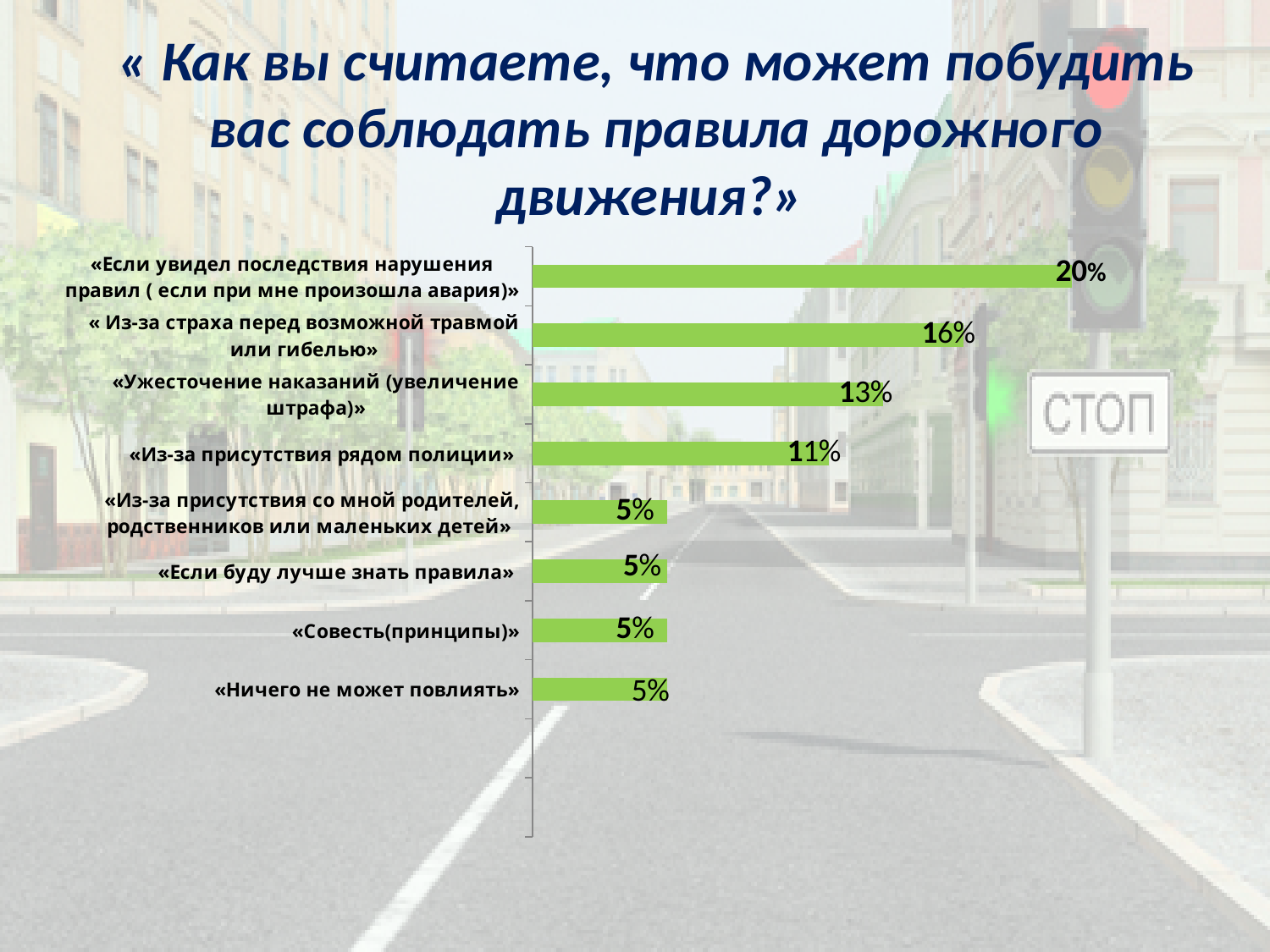
How many categories does the chart show? 8 What is the difference between the values for «Если увидел последствия нарушения правил ( если при мне произошла авария)» and « Из-за страха перед возможной травмой или гибелью»? 4% What colour are the bars in the chart? green What kind of chart is shown on the slide? bar chart What is the value for « Из-за страха перед возможной травмой или гибелью»? 16% What is the value for «Ужесточение наказаний (увеличение штрафа)»? 13% What is the value for «Если увидел последствия нарушения правил ( если при мне произошла авария)»? 20% What is the difference between the values for «Из-за присутствия рядом полиции» and «Совесть(принципы)»? 6% What is the value for «Из-за присутствия рядом полиции»? 11% What is the value for «Ничего не может повлиять»? 5% Which category has the highest value? «Если увидел последствия нарушения правил ( если при мне произошла авария)» Which is larger, the value for «Ужесточение наказаний (увеличение штрафа)» or the value for «Из-за присутствия рядом полиции»? «Ужесточение наказаний (увеличение штрафа)»